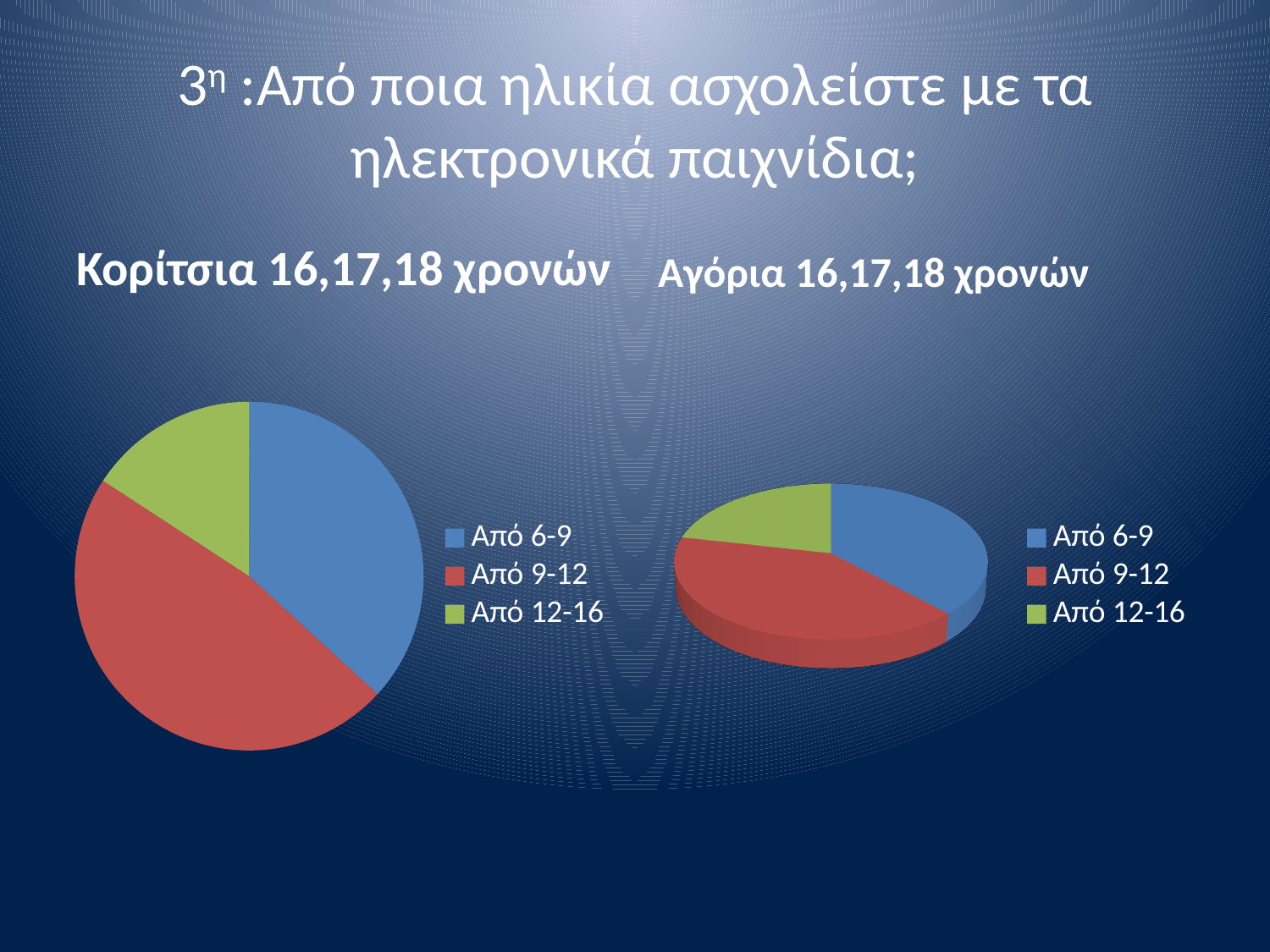
In the "Αγόρια 16,17,18 χρονών" chart, which slice is larger: Από 6-9 or Από 9-12? Από 9-12 In the "Αγόρια 16,17,18 χρονών" chart, which slice is larger: Από 9-12 or Από 12-16? Από 9-12 In the "Αγόρια 16,17,18 χρονών" chart, which category has the largest slice? Από 9-12 What kind of chart is the "Κορίτσια 16,17,18 χρονών" chart? pie chart In the "Κορίτσια 16,17,18 χρονών" chart, which category has the smallest slice? Από 12-16 How many slices does the "Κορίτσια 16,17,18 χρονών" pie chart have? 3 How many entries does the legend of the "Αγόρια 16,17,18 χρονών" chart list? 3 What is the title of the chart on the right side of the slide? Αγόρια 16,17,18 χρονών What kind of chart is the "Αγόρια 16,17,18 χρονών" chart? pie chart What colour represents the "Από 9-12" category in the "Κορίτσια 16,17,18 χρονών" chart? red In the "Αγόρια 16,17,18 χρονών" chart, which category has the smallest slice? Από 12-16 In the "Κορίτσια 16,17,18 χρονών" chart, which slice is larger: Από 6-9 or Από 12-16? Από 6-9